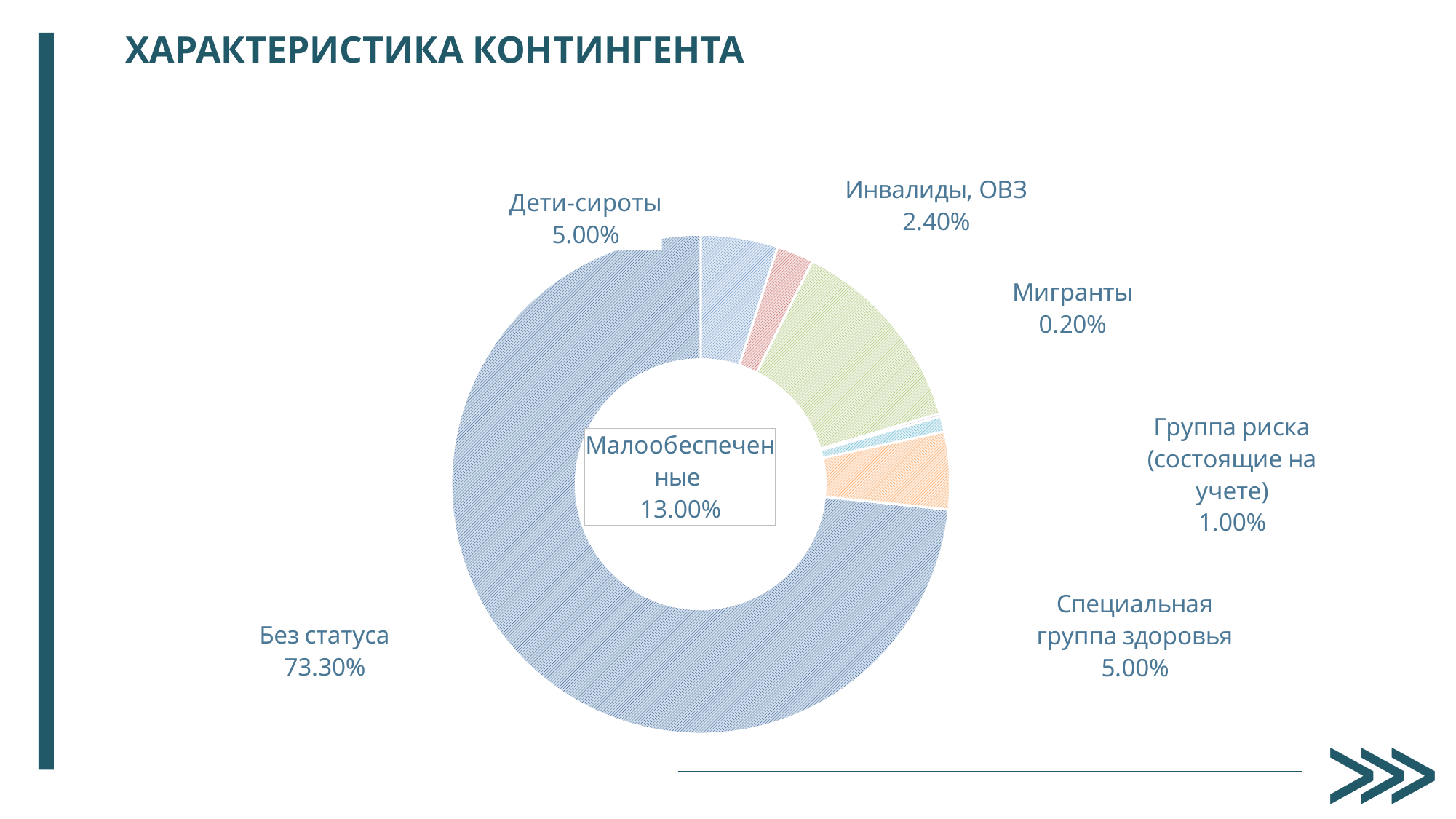
How many categories does the chart show? 7 What is the value for Группа риска (состоящие на учете)? 1.00% What is the value for Без статуса? 73.30% What is the difference between the shares of Инвалиды, ОВЗ and Мигранты? 2.20% Which is larger, the share of Дети-сироты or the share of Инвалиды, ОВЗ? Дети-сироты What is the value for Инвалиды, ОВЗ? 2.40% Which category has the largest share? Без статуса Which category has the smallest share? Мигранты What is the difference between the shares of Без статуса and Малообеспеченные? 60.30% What kind of chart is shown on the slide? Doughnut (pie) chart What is the title of the chart on the slide? ХАРАКТЕРИСТИКА КОНТИНГЕНТА What is the value for Малообеспеченные? 13.00%